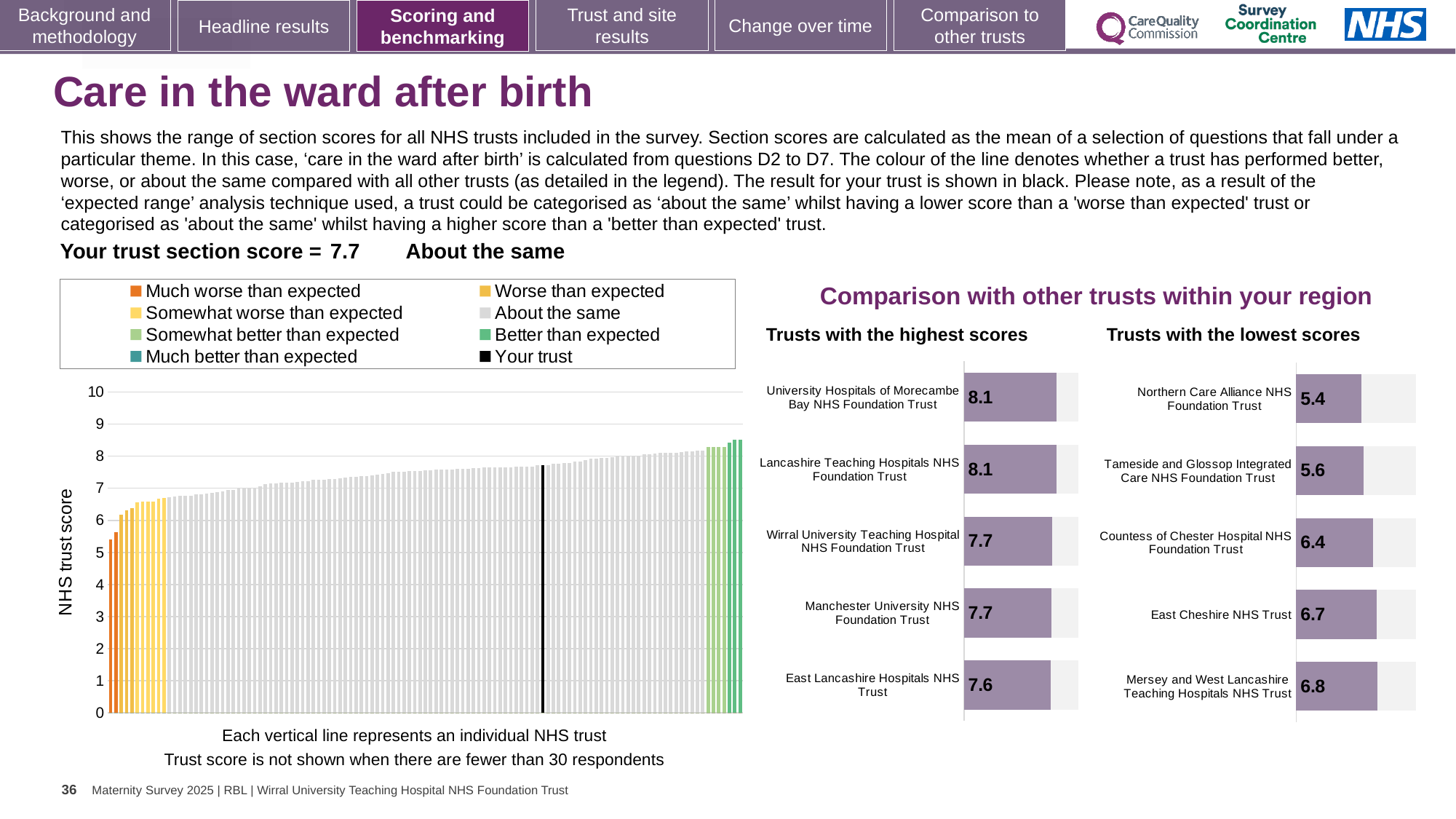
In the 'Trusts with the highest scores' chart, what is the difference between the scores of Lancashire Teaching Hospitals NHS Foundation Trust and East Lancashire Hospitals NHS Trust? 0.5 In the 'Trusts with the lowest scores' chart, what is the difference between the scores of Mersey and West Lancashire Teaching Hospitals NHS Trust and Northern Care Alliance NHS Foundation Trust? 1.4 In the large 'NHS trust score' chart on the left, do the bar heights rise or fall from left to right? Rise How many entries does the legend of the large 'NHS trust score' chart on the left list? 8 In the 'Trusts with the lowest scores' chart, what is the score for Countess of Chester Hospital NHS Foundation Trust? 6.4 In the 'Trusts with the lowest scores' chart, which trust has the highest score? Mersey and West Lancashire Teaching Hospitals NHS Trust In the 'Trusts with the lowest scores' chart, which trust has the lowest score? Northern Care Alliance NHS Foundation Trust How many trusts are listed in the 'Trusts with the highest scores' chart? 5 In the 'Trusts with the highest scores' chart, what is the score for University Hospitals of Morecambe Bay NHS Foundation Trust? 8.1 In the 'Trusts with the highest scores' chart, what is the score for East Lancashire Hospitals NHS Trust? 7.6 What kind of chart is the large chart on the left with the 'NHS trust score' axis? Bar chart In the 'Trusts with the lowest scores' chart, which has the larger score: Tameside and Glossop Integrated Care NHS Foundation Trust or East Cheshire NHS Trust? East Cheshire NHS Trust